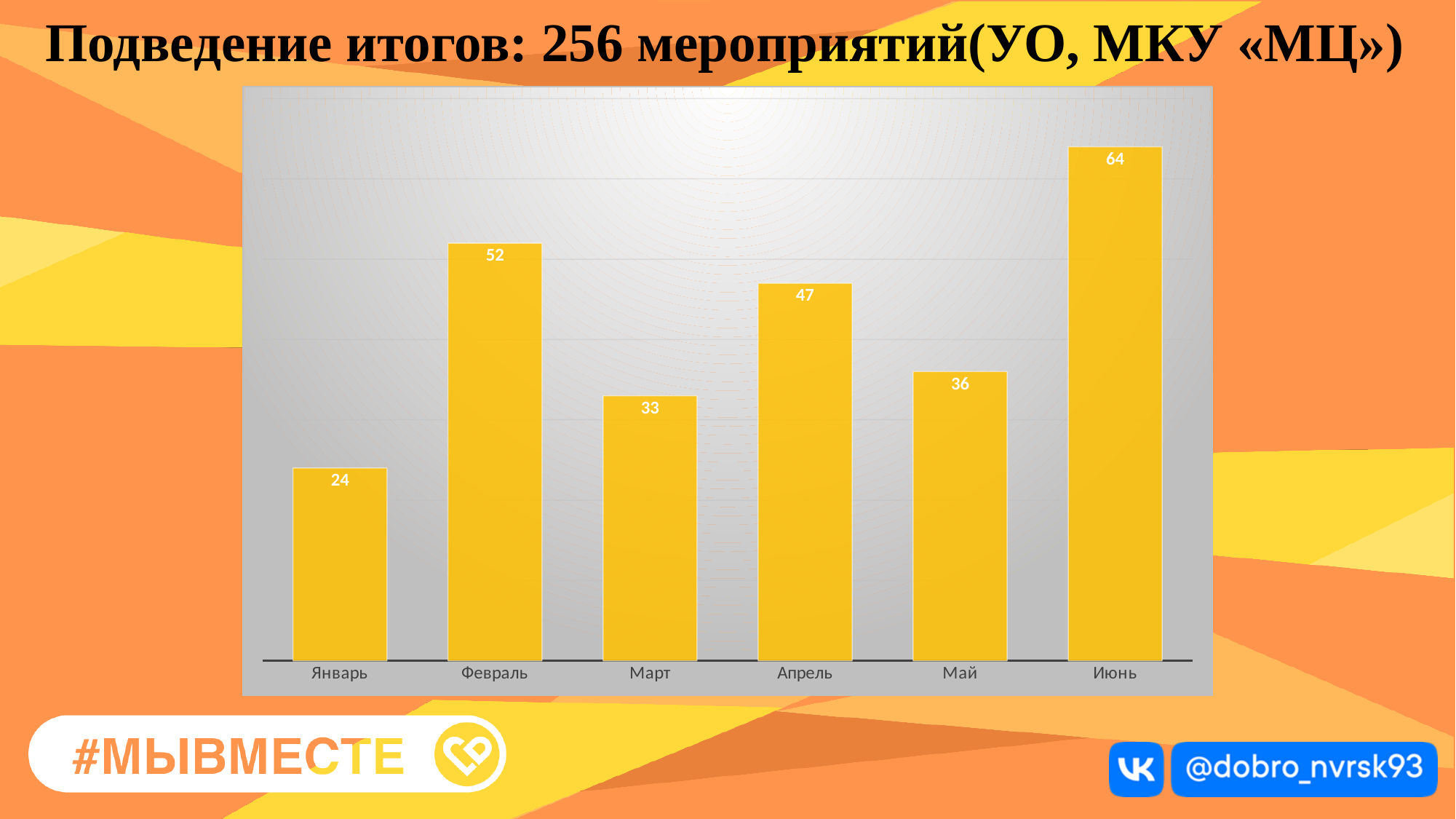
What is the title of the slide? Подведение итогов: 256 мероприятий(УО, МКУ «МЦ») What is the value for Апрель? 47 Which is larger, the value for Февраль or the value for Апрель? Февраль What kind of chart is shown on the slide? Bar chart Which month has the lowest value? Январь What is the difference between the values for Июнь and Январь? 40 Which is larger, the value for Март or the value for Май? Май What is the difference between the values for Февраль and Март? 19 What is the value for Январь? 24 How many months are shown on the x axis? 6 Which month has the highest value? Июнь What is the value for Май? 36